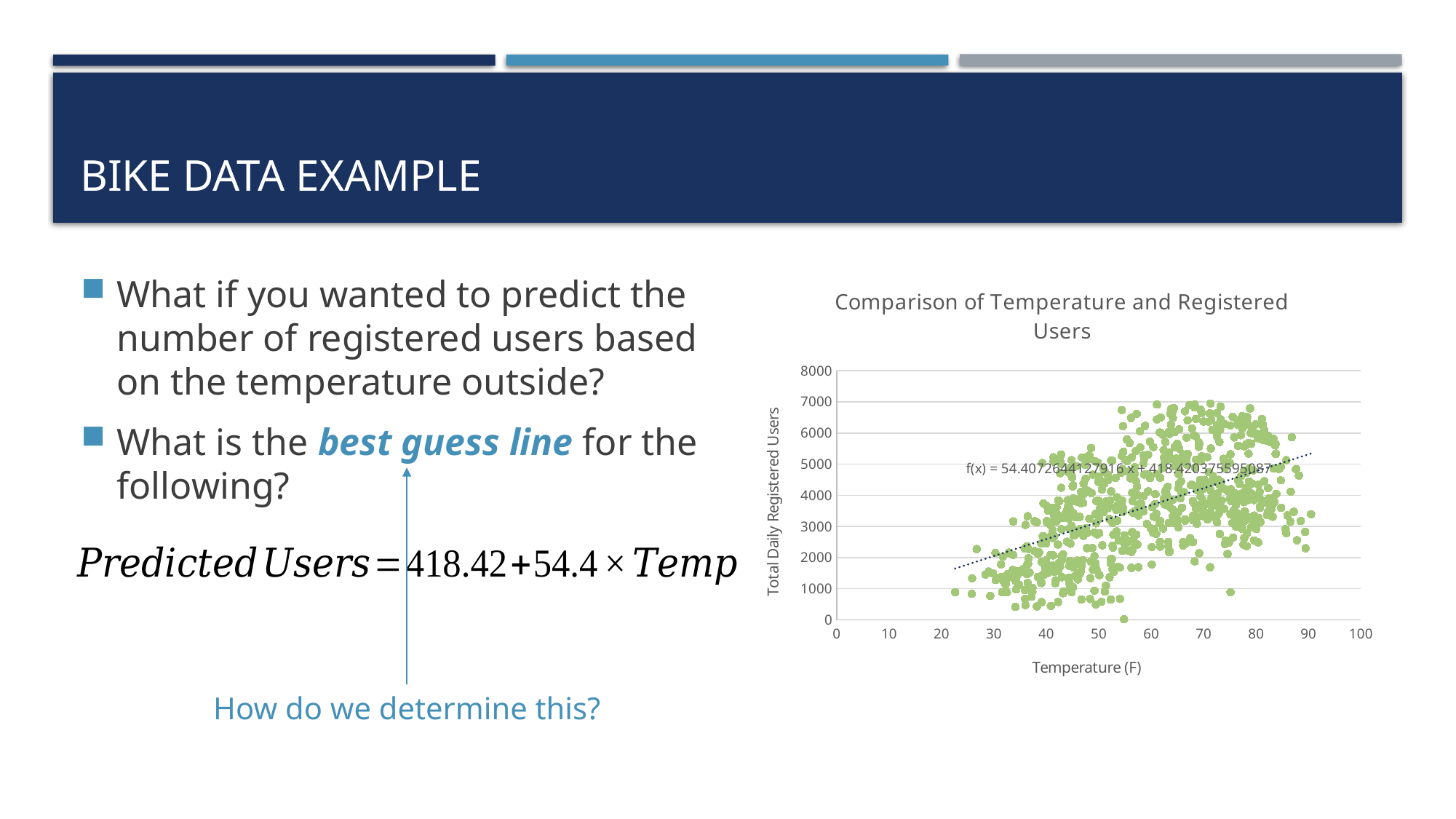
What kind of chart is shown on the slide? Scatter chart Is the lowest temperature plotted on the chart greater or less than 30? less What is the highest value shown on the vertical axis of the chart? 8000 What is the title of the chart on the slide? Comparison of Temperature and Registered Users Do the registered user values generally rise or fall as temperature increases along the x axis? Rise What is the slope of the trendline equation printed on the chart? 54.4072644127916 Is the highest temperature plotted on the chart greater or less than 80? greater What is the label of the vertical axis of the chart? Total Daily Registered Users Is the highest registered users value plotted on the chart greater or less than 6000? greater What is the highest value shown on the horizontal axis of the chart? 100